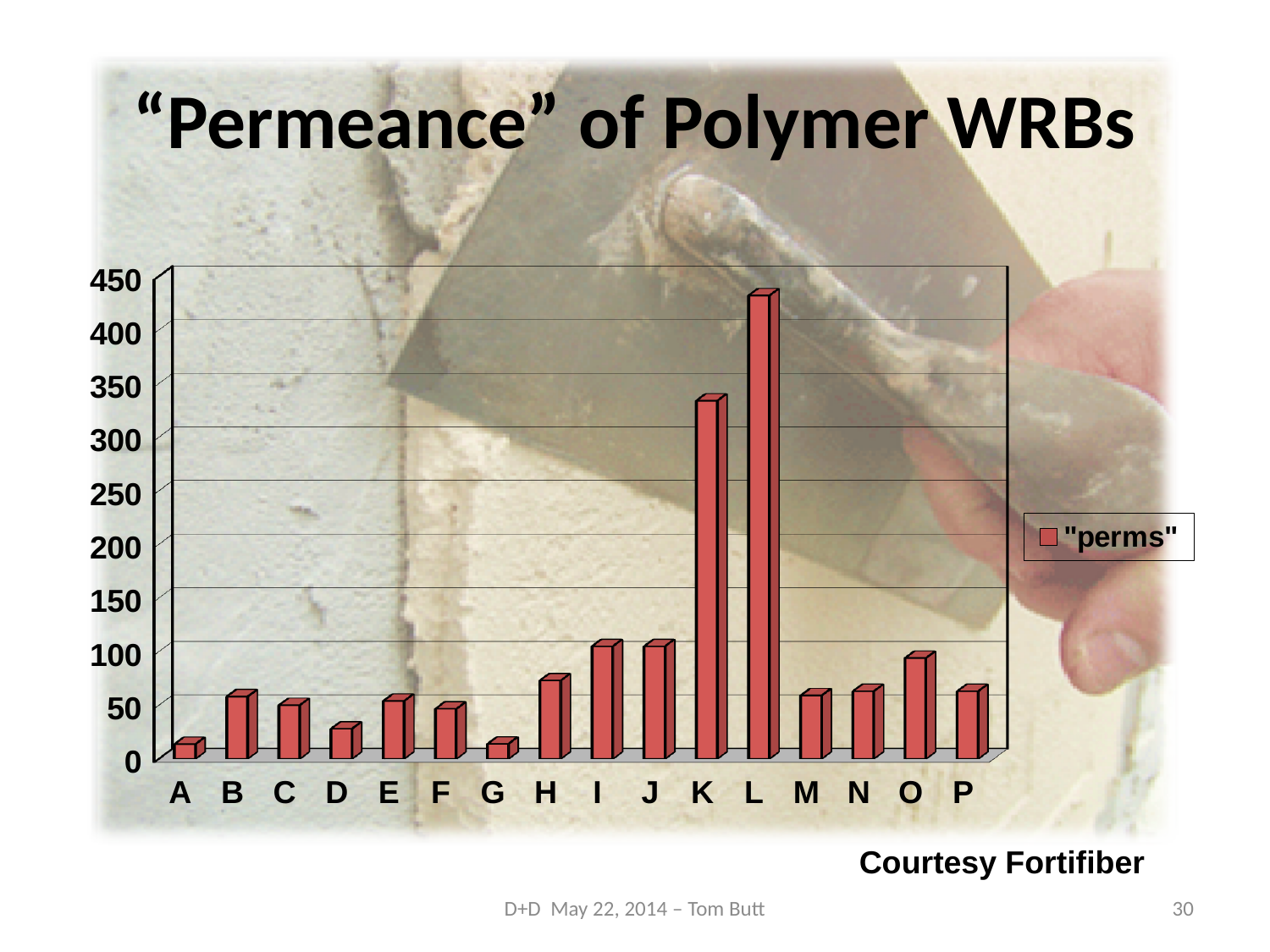
Is the value for D greater or less than 50? less Is the value for K greater or less than 300? greater How many categories are plotted along the x axis? 16 Is the value for H greater or less than 50? greater Which is larger, the value for O or the value for D? O What is the name of the series shown in the legend? "perms" Which category has the highest value? L What kind of chart is shown on the slide? bar chart How many series does the legend list? 1 Which is larger, the value for K or the value for L? L